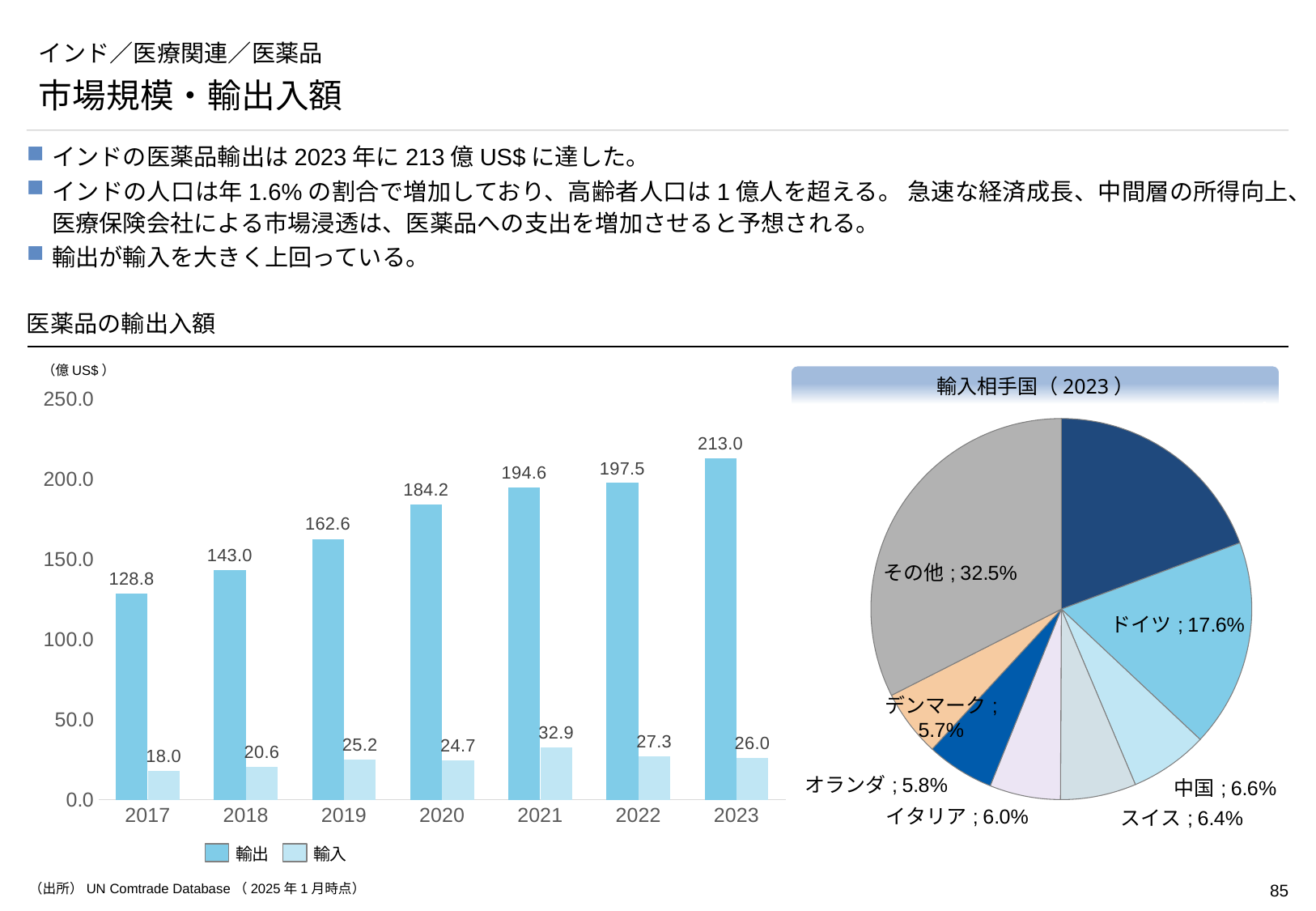
In the pie chart 輸入相手国（2023）, which labelled slice is larger, 中国 or スイス? 中国 What kind of chart is the chart titled 輸入相手国（2023）? pie chart In the bar chart 医薬品の輸出入額, which year has the highest 輸入 value? 2021 In the bar chart 医薬品の輸出入額, how many series does the legend list? 2 In the bar chart 医薬品の輸出入額, which year has the lowest 輸出 value? 2017 In the bar chart 医薬品の輸出入額, what is the 輸出 value for 2023? 213.0 In the bar chart 医薬品の輸出入額, what is the difference between the 輸出 and 輸入 values in 2023? 187.0 In the bar chart 医薬品の輸出入額, is the 輸入 value for 2018 larger or smaller than the 輸入 value for 2019? smaller In the pie chart 輸入相手国（2023）, what share does ドイツ have? 17.6% In the bar chart 医薬品の輸出入額, does the 輸出 value rise or fall from 2017 to 2023? rise In the bar chart 医薬品の輸出入額, how many years are shown on the x axis? 7 In the bar chart 医薬品の輸出入額, what is the 輸入 value for 2021? 32.9